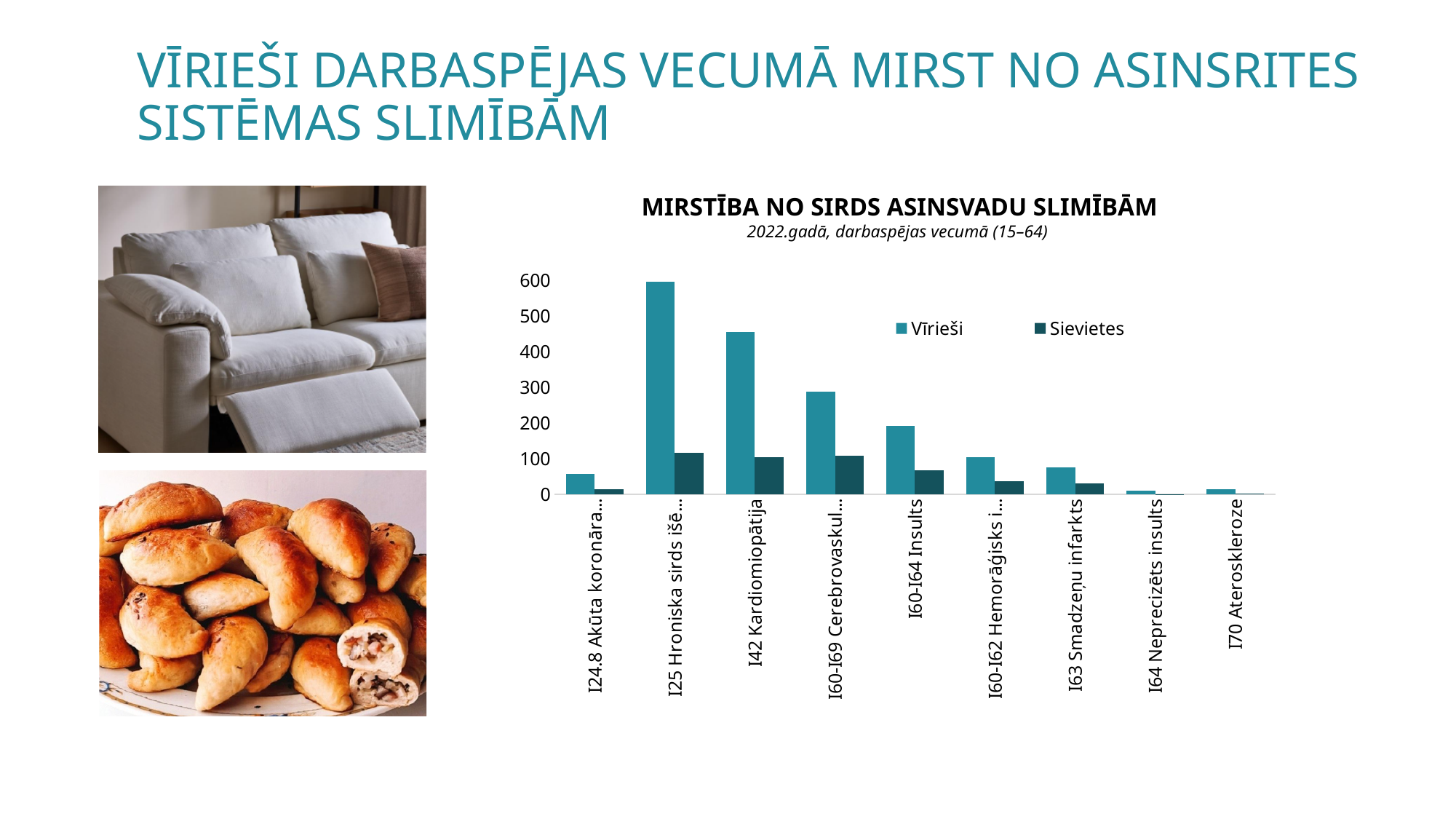
Is the value for Vīrieši in I42 Kardiomiopātija greater or less than 400? greater Is the value for Sievietes in I42 Kardiomiopātija greater or less than 200? less Which category has the highest value for Vīrieši? I25 Hroniska sirds išē... How many series does the legend of the chart list? 2 Which category has the highest value for Sievietes? I25 Hroniska sirds išē... Is the value for Vīrieši in I60-I64 Insults greater or less than 100? greater Which two series are listed in the chart legend? Vīrieši and Sievietes What kind of chart is shown on the slide? bar chart What is the title of the chart? MIRSTĪBA NO SIRDS ASINSVADU SLIMĪBĀM For Vīrieši, which is larger: the value for I42 Kardiomiopātija or for I60-I69 Cerebrovaskul...? I42 Kardiomiopātija How many categories are shown on the x axis of the chart? 9 For I63 Smadzeņu infarkts, which is larger: the value for Vīrieši or for Sievietes? Vīrieši